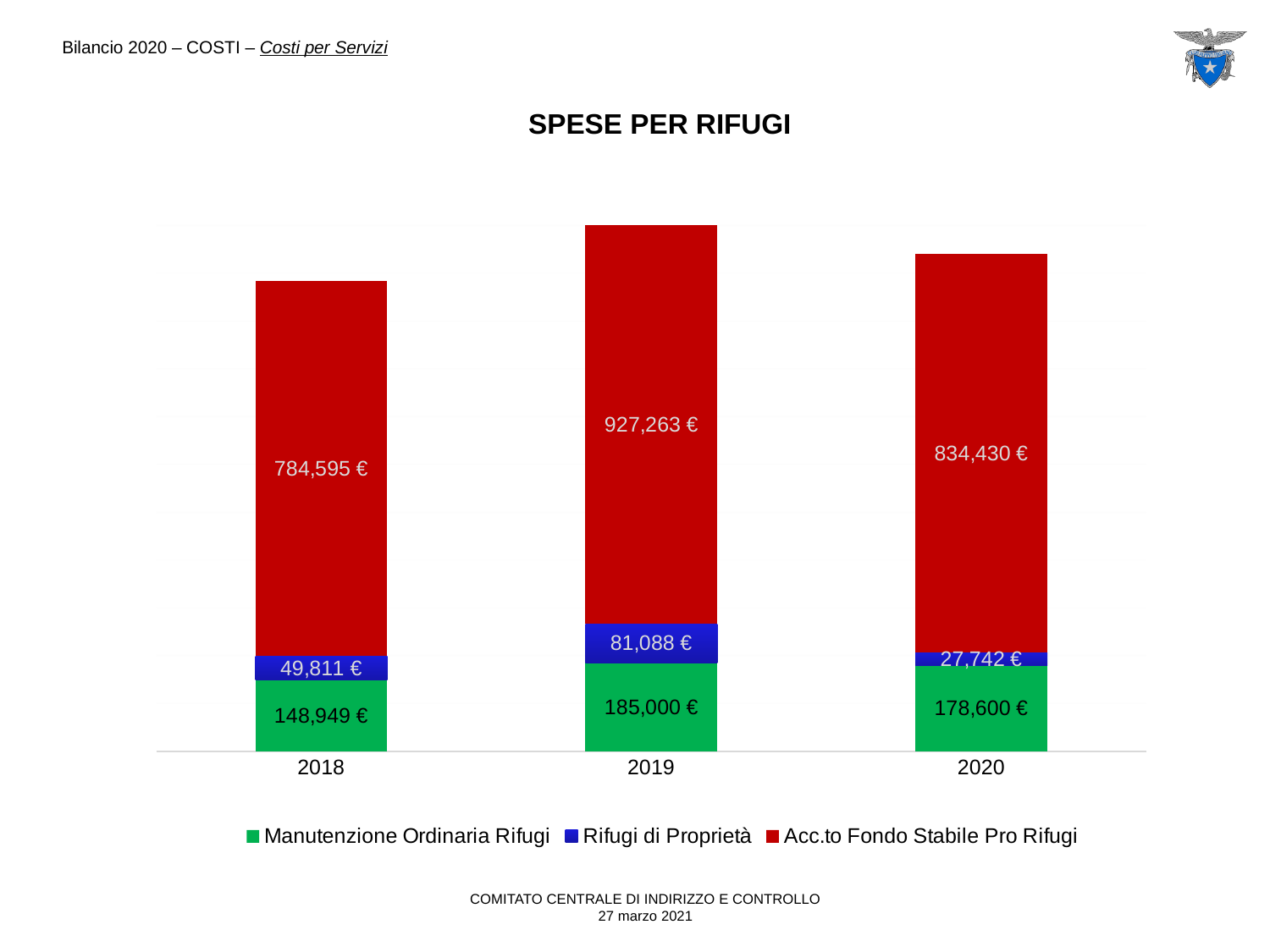
What is the difference between the Acc.to Fondo Stabile Pro Rifugi values for 2019 and 2018? 142,668 € How many years are shown on the x axis? 3 Which year has the lowest value for Acc.to Fondo Stabile Pro Rifugi? 2018 What is the value of Rifugi di Proprietà for 2020? 27,742 € Which year has the highest value for Rifugi di Proprietà? 2019 How many series does the legend list? 3 What is the total of the stacked bar for 2020? 1,040,772 € What is the value of Acc.to Fondo Stabile Pro Rifugi for 2019? 927,263 € What is the value of Manutenzione Ordinaria Rifugi for 2018? 148,949 € What is the total of the stacked bar for 2018? 983,355 € What type of chart is shown? Stacked bar chart Which is larger: Manutenzione Ordinaria Rifugi in 2019 or in 2020? 2019